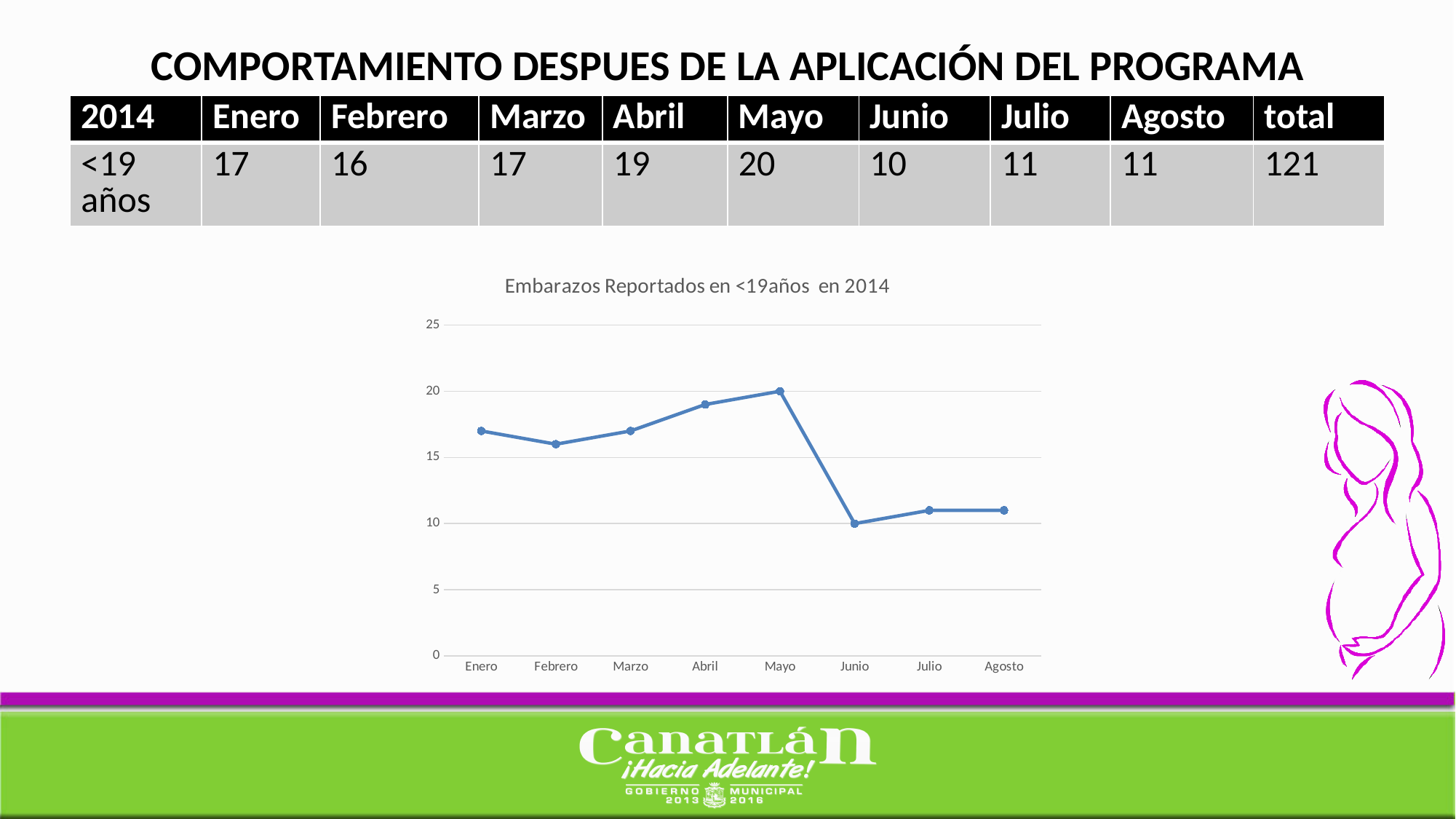
What type of chart is shown on the slide? line chart What is the value for Junio in the chart? 10 What is the difference between the values for Mayo and Junio? 10 Is the value for Julio greater or less than 15? less What is the value for Febrero in the chart? 16 How many months are plotted on the x axis of the chart? 8 Which month has the highest value in the chart? Mayo Which month has the lowest value in the chart? Junio What is the title of the chart? Embarazos Reportados en <19años en 2014 Does the line rise or fall from Mayo to Junio? fall Which is larger, the value for Abril or the value for Febrero? Abril What is the value for Mayo in the chart? 20